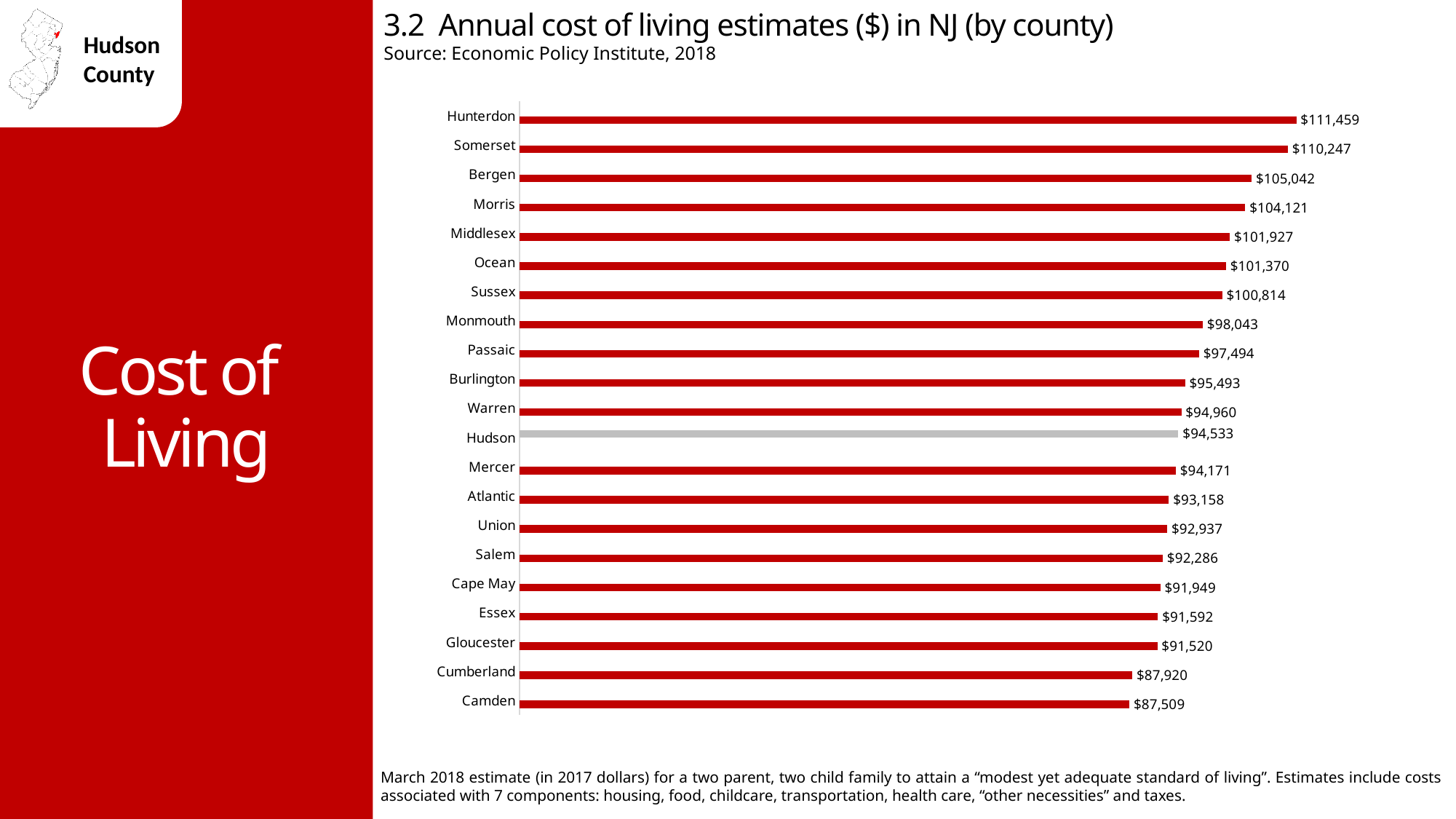
What is the difference between the cost of living estimates for Hunterdon and Camden? $23,950 Which county has a higher cost of living estimate, Morris or Middlesex? Morris What type of chart is used to show the annual cost of living estimates? Bar chart What is the annual cost of living estimate for Camden County? $87,509 How many counties are shown in the chart? 21 Which county has a higher cost of living estimate, Essex or Cumberland? Essex What is the annual cost of living estimate for Hudson County? $94,533 What is the annual cost of living estimate for Bergen County? $105,042 Which county's bar is shown in grey instead of red? Hudson What is the difference between the cost of living estimates for Hudson and Camden? $7,024 Which county has the lowest annual cost of living estimate? Camden Which county has the highest annual cost of living estimate? Hunterdon